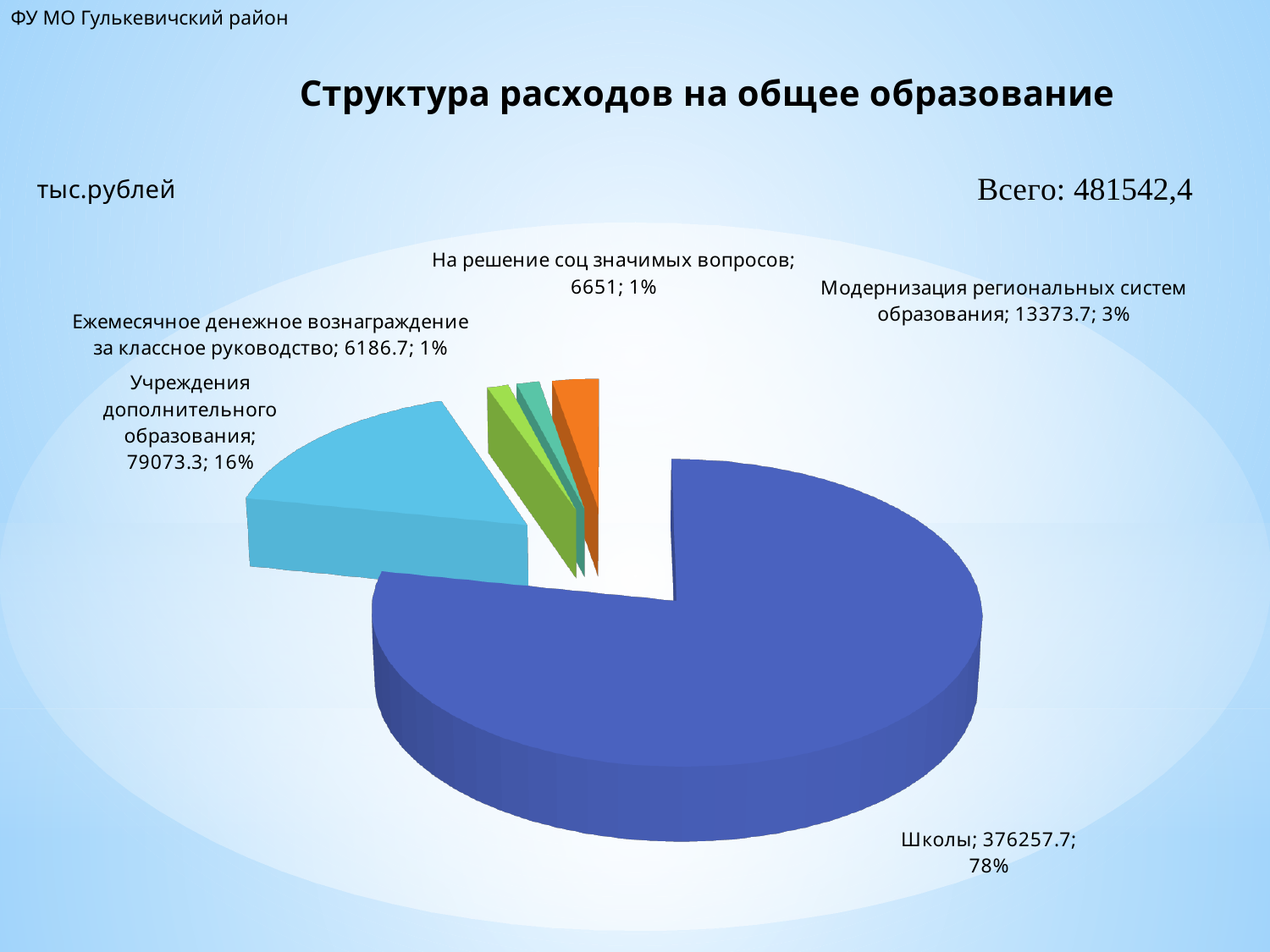
What share of the pie does Школы take? 78% What type of chart is shown on the slide? pie chart What is the value for Учреждения дополнительного образования? 79073.3 Which category has the smallest slice? Ежемесячное денежное вознаграждение за классное руководство What is the value for Модернизация региональных систем образования? 13373.7 Which category has the largest slice? Школы What is the value for Ежемесячное денежное вознаграждение за классное руководство? 6186.7 What share of the pie does Учреждения дополнительного образования take? 16% How many slices does the pie chart have? 5 What is the value for Школы? 376257.7 What is the difference between the values for Школы and Учреждения дополнительного образования? 297184.4 What is the value for На решение соц значимых вопросов? 6651